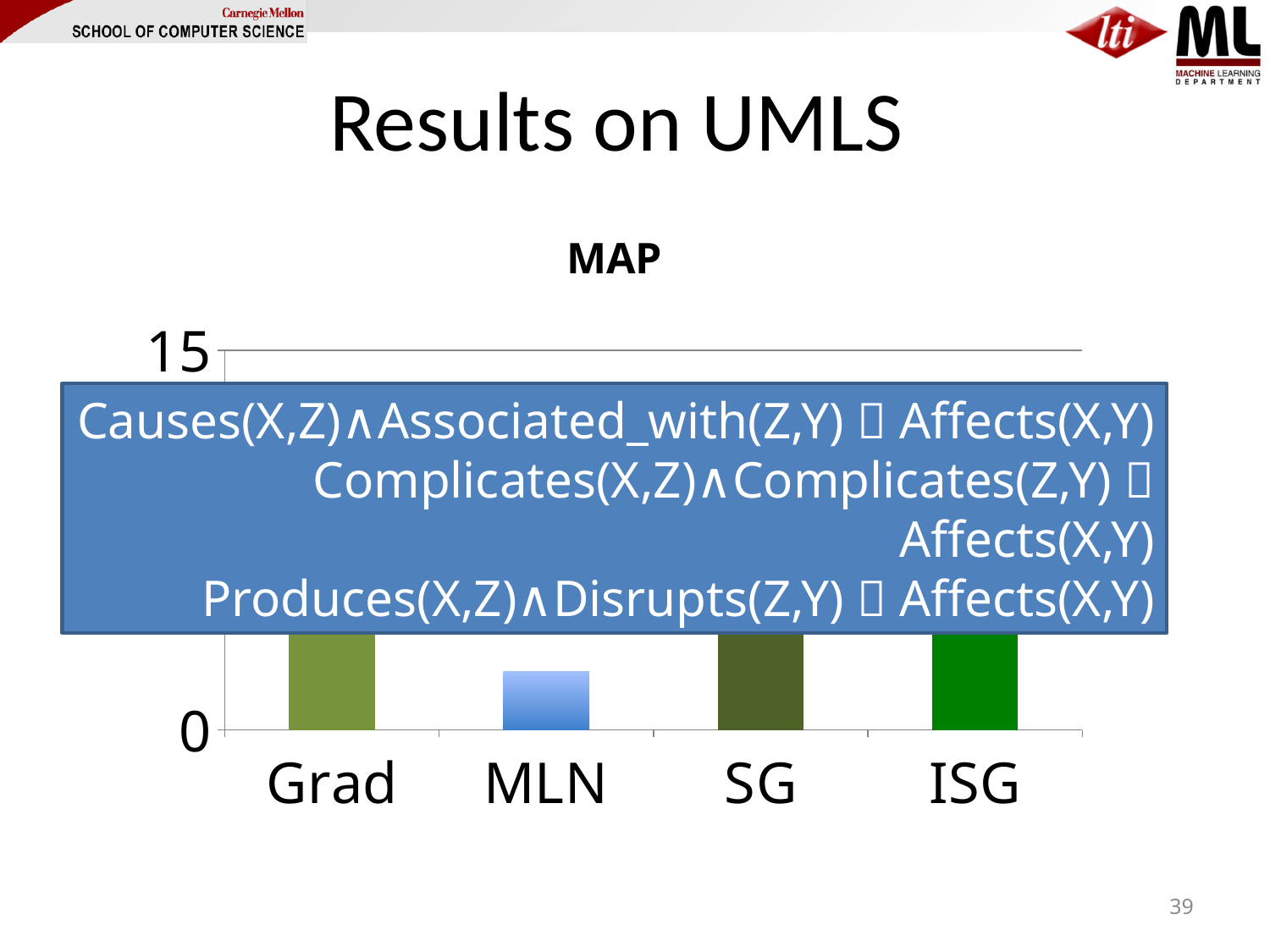
What is the label of the second category from the left on the x axis? MLN What kind of chart is shown on the slide? bar chart Is the MAP value for MLN greater or less than 15? less What is the highest value shown on the y axis of the chart? 15 Which category has the lowest MAP value? MLN How many categories are shown on the x axis of the chart? 4 Which is larger, the MAP value for ISG or for MLN? ISG What is the title of the chart? MAP Which is larger, the MAP value for Grad or for MLN? Grad Which is larger, the MAP value for SG or for MLN? SG